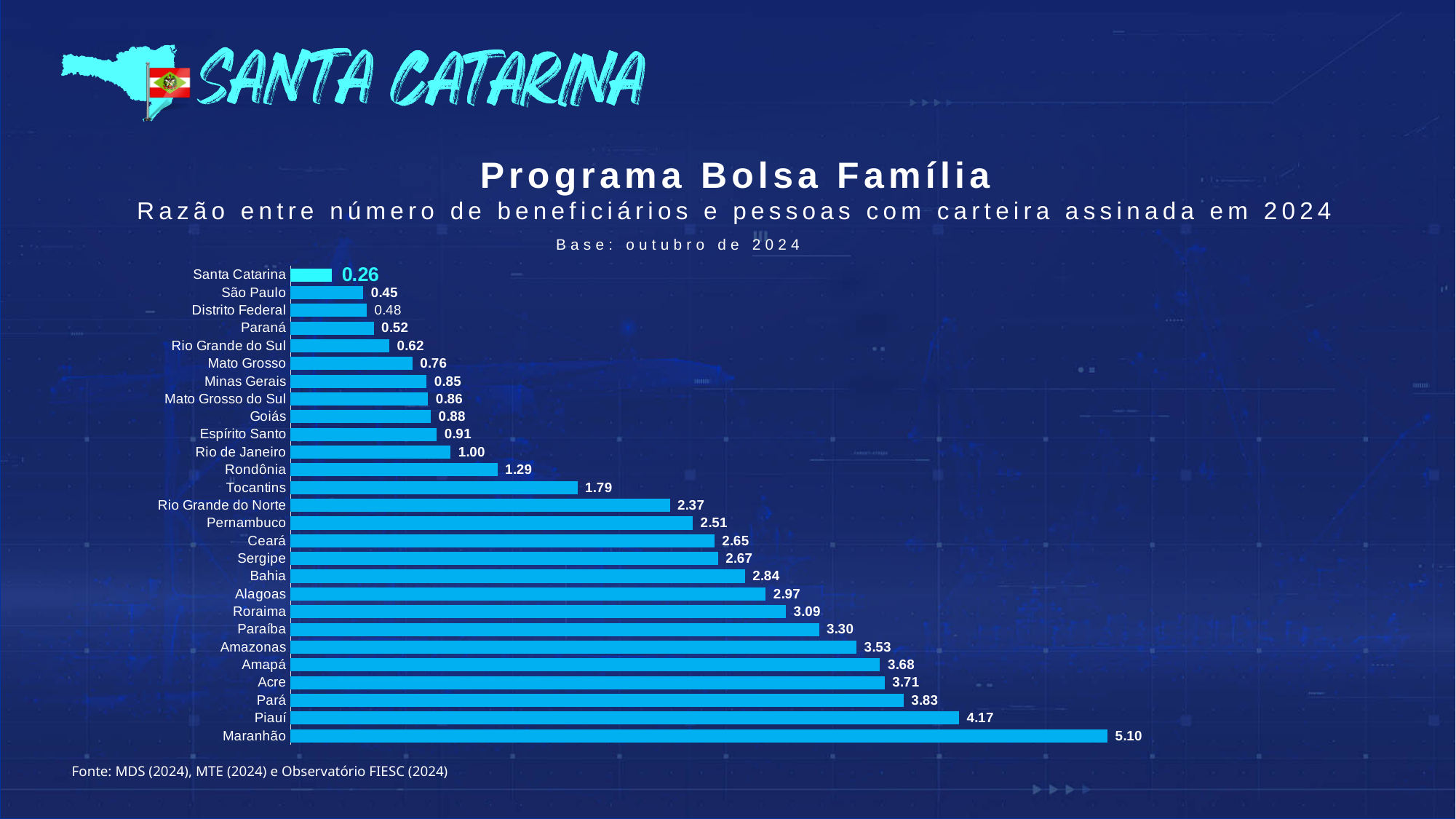
What is the value for Maranhão? 5.10 What is the difference between the values for Maranhão and Santa Catarina? 4.84 What is the difference between the values for Piauí and Pará? 0.34 How many states are shown in the chart? 27 Which state has the highest value? Maranhão What is the value for Rio de Janeiro? 1.00 What is the base date stated below the chart subtitle? outubro de 2024 What is the value for Tocantins? 1.79 Which has a larger value, Bahia or Rondônia? Bahia Which state has the lowest value? Santa Catarina What kind of chart is shown on the slide? Bar chart What is the value for Santa Catarina? 0.26